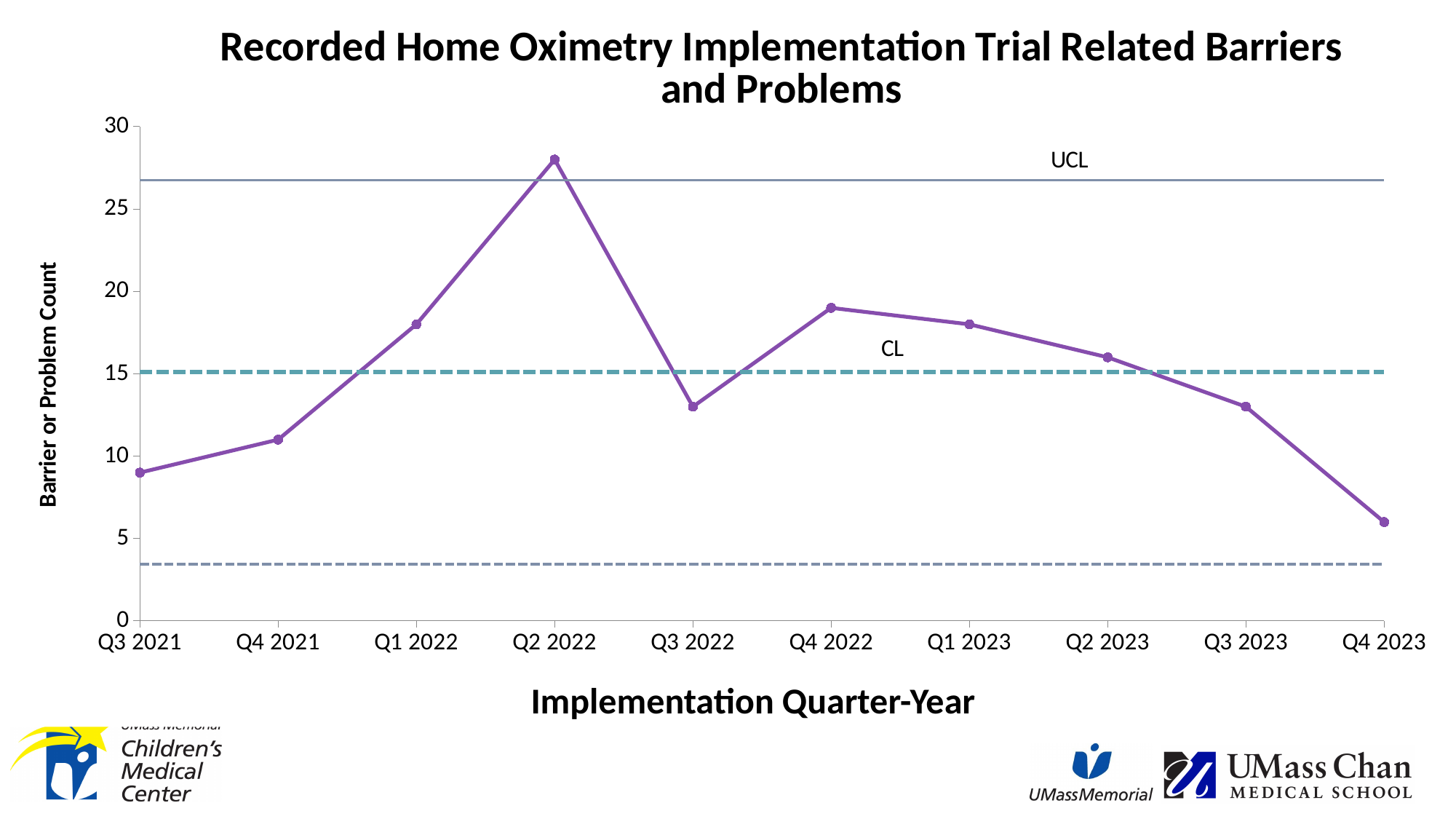
What is the title of the chart? Recorded Home Oximetry Implementation Trial Related Barriers and Problems What is the label of the y axis? Barrier or Problem Count Which quarter has the highest barrier or problem count? Q2 2022 Is the value for Q3 2021 greater or less than 10? less Is the value for Q4 2023 greater or less than 10? less How many quarter-year points are plotted on the x axis? 10 Which quarter has the lowest barrier or problem count? Q4 2023 What kind of chart is shown on the slide? line chart Do the values rise or fall from Q4 2022 to Q4 2023? fall Which has the larger barrier or problem count, Q1 2022 or Q3 2022? Q1 2022 Is the value for Q2 2022 greater or less than 25? greater